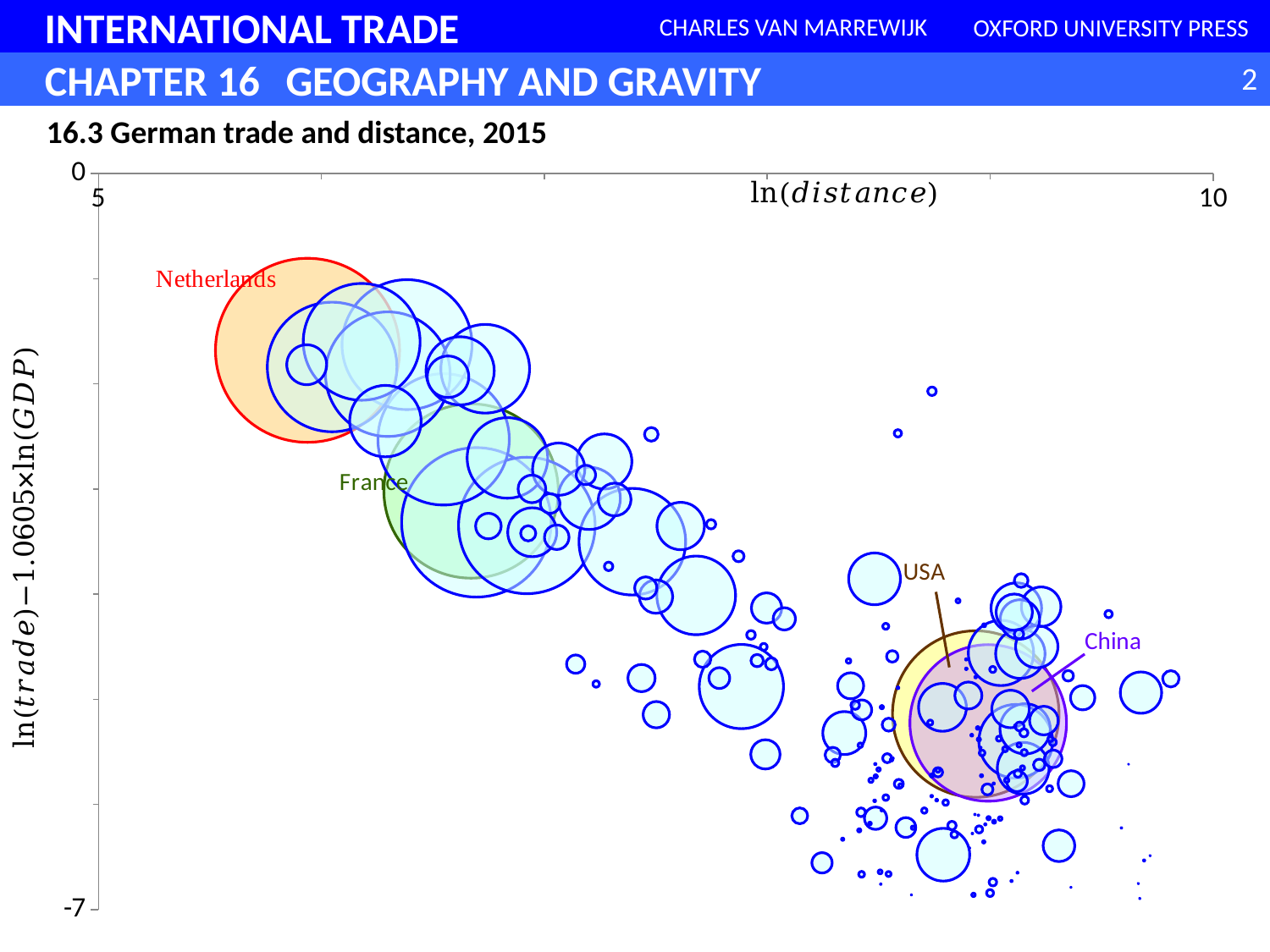
What variable is plotted on the x axis? ln(distance) Which labelled country has the higher value on the vertical axis, Netherlands or China? Netherlands Do the plotted values generally rise or fall as ln(distance) increases? Fall Which labelled country has the largest ln(distance) value? China Is the vertical-axis value for the Netherlands greater or less than -3? greater How many countries are labelled by name on the chart? 4 Which labelled country has the smallest ln(distance) value? Netherlands Is the vertical-axis value for the USA greater or less than -4? less What is the title of the chart? 16.3 German trade and distance, 2015 Is the ln(distance) value for the Netherlands greater or less than 7? less What kind of chart is shown on the slide? Bubble (scatter) chart